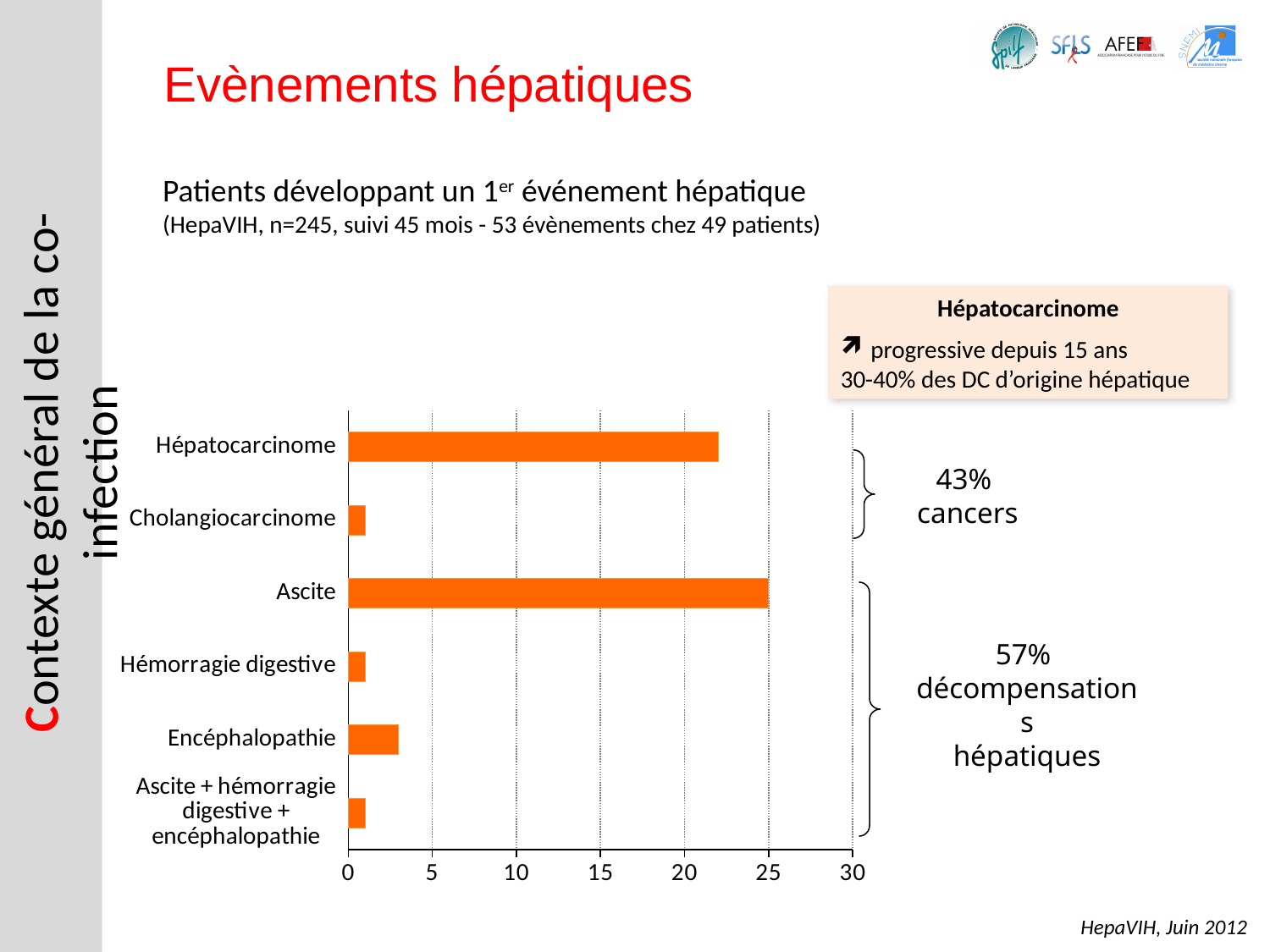
What is the value for Ascite? 25 Which is larger, the value for Encéphalopathie or the value for Cholangiocarcinome? Encéphalopathie What kind of chart is shown on the slide? bar chart Is the value for Hémorragie digestive greater or less than 5? less Is the value for Hépatocarcinome greater or less than 20? greater Is the value for Encéphalopathie greater or less than 5? less Which is larger, the value for Hépatocarcinome or the value for Ascite? Ascite What is the highest value shown on the x axis of the chart? 30 Which category has the highest value in the chart? Ascite According to the annotation next to the chart, what percentage of events are cancers? 43% How many categories are plotted in the chart? 6